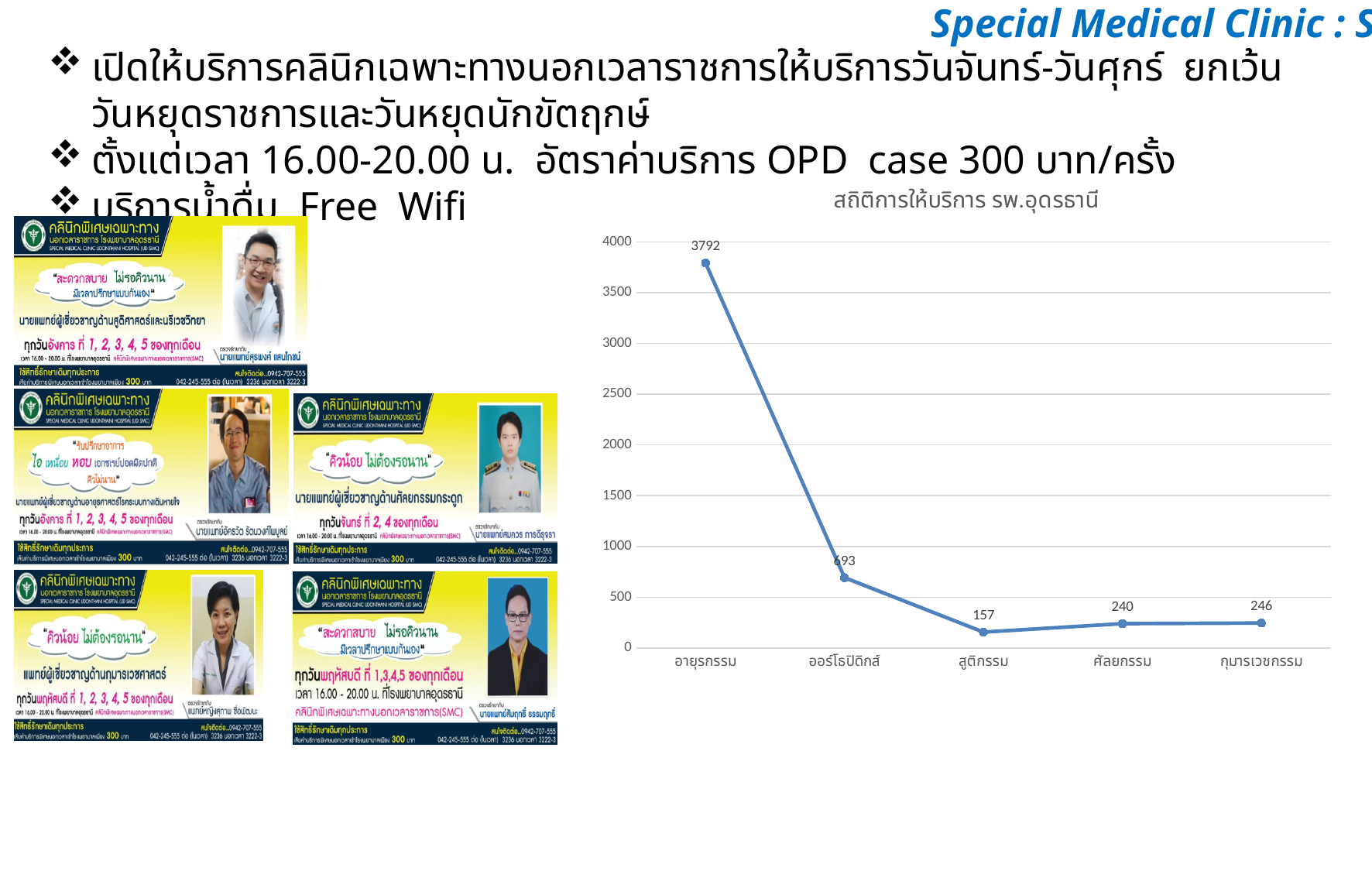
What is the value for กุมารเวชกรรม? 246 What is the value for อายุรกรรม? 3792 What is the difference between the values for กุมารเวชกรรม and ศัลยกรรม? 6 What is the title of the chart? สถิติการให้บริการ รพ.อุดรธานี What is the value for ศัลยกรรม? 240 How many categories are shown on the x axis? 5 Which is larger, the value for ศัลยกรรม or the value for สูติกรรม? ศัลยกรรม What is the value for สูติกรรม? 157 Is the value for ออร์โธปิดิกส์ greater or less than 1000? less Which category has the lowest value? สูติกรรม What type of chart is shown on the slide? line chart Which category has the highest value? อายุรกรรม